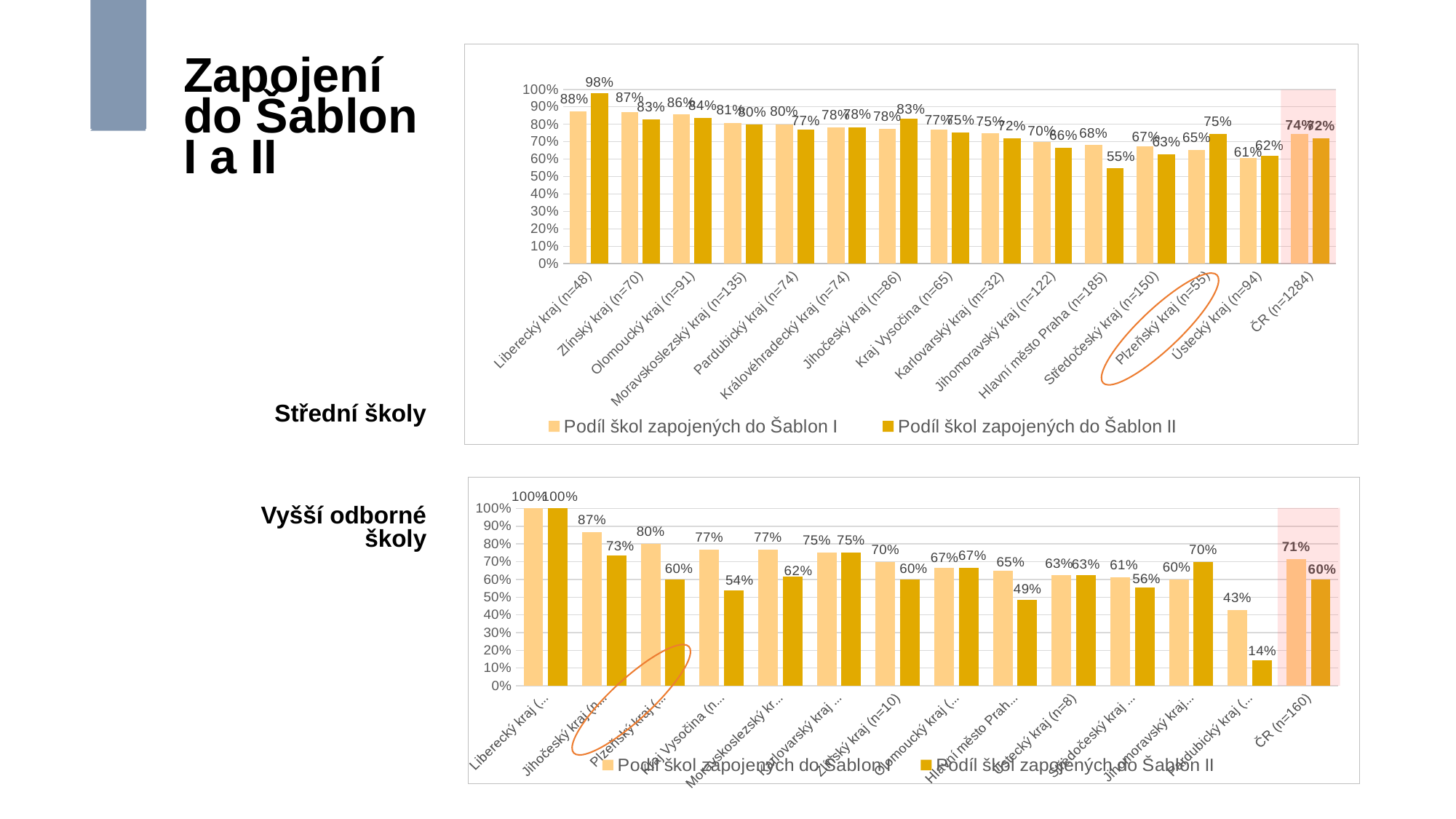
In the bottom chart (Vyšší odborné školy), what is the difference between the Šablon I and Šablon II values for Plzeňský kraj? 20% In the top chart (Střední školy), how many categories are shown on the x axis? 15 In the bottom chart (Vyšší odborné školy), what is the value of Podíl škol zapojených do Šablon I for ČR (n=160)? 71% In the top chart (Střední školy), what is the value of Podíl škol zapojených do Šablon II for Liberecký kraj (n=48)? 98% In the bottom chart (Vyšší odborné školy), which is larger for Jihomoravský kraj: the Šablon I value or the Šablon II value? Šablon II In the top chart (Střední školy), how many series does the legend list? 2 In the top chart (Střední školy), what is the difference between the Šablon I and Šablon II values for ČR (n=1284)? 2% What type of chart is the bottom chart (Vyšší odborné školy)? Bar chart In the bottom chart (Vyšší odborné školy), what is the value of Podíl škol zapojených do Šablon II for Pardubický kraj? 14% In the top chart (Střední školy), which category has the lowest value for Podíl škol zapojených do Šablon II? Hlavní město Praha (n=185) In the bottom chart (Vyšší odborné školy), which category has the highest value for Podíl škol zapojených do Šablon I? Liberecký kraj In the top chart (Střední školy), what is the value of Podíl škol zapojených do Šablon I for Plzeňský kraj (n=55)? 65%